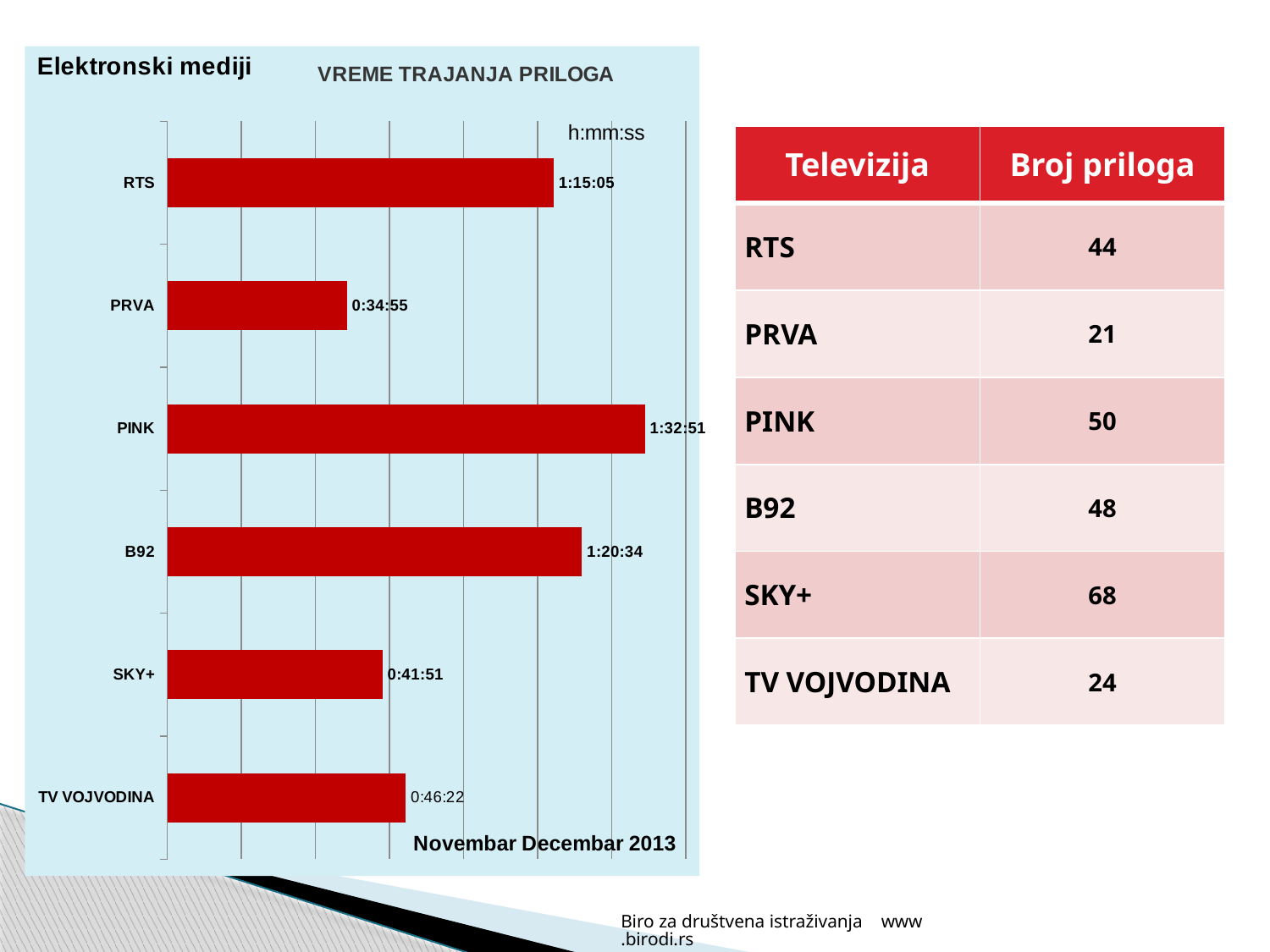
What is the value for RTS in the chart? 1:15:05 What is the title of the chart? VREME TRAJANJA PRILOGA What is the value for SKY+ in the chart? 0:41:51 What is the value for TV VOJVODINA in the chart? 0:46:22 What type of chart is shown on the slide? bar chart What is the value for PINK in the chart? 1:32:51 Which has a larger value in the chart, B92 or RTS? B92 Which television station has the longest total duration of reports in the chart? PINK Which television station has the shortest total duration of reports in the chart? PRVA What is the difference between the values for PINK and RTS in the chart? 0:17:46 How many television stations are shown in the chart? 6 In what format are the values in the chart expressed, according to the label in the chart? h:mm:ss